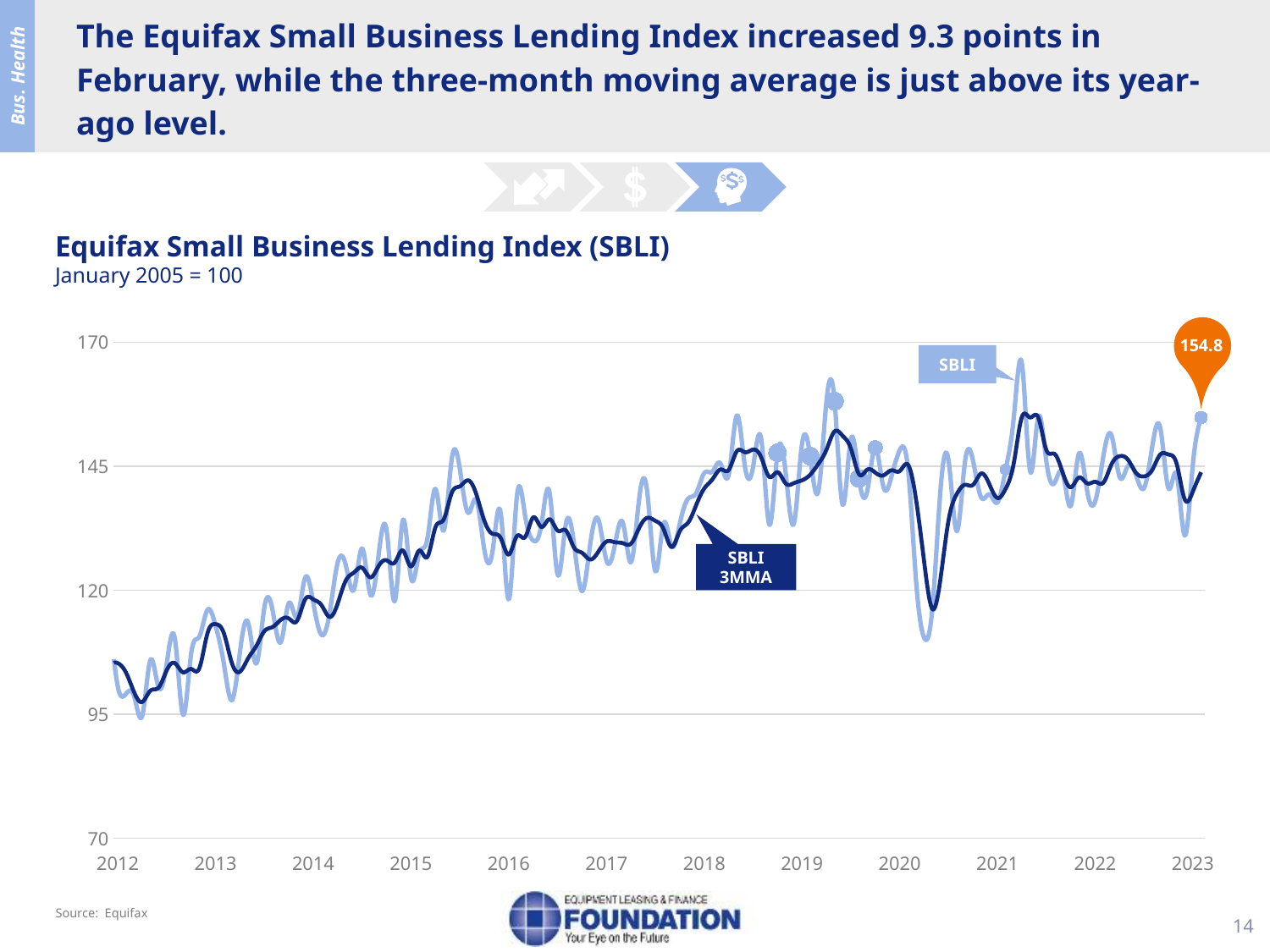
Is the SBLI value at the start of 2012 greater or less than 120? less Which is higher, the SBLI at the start of 2012 or the SBLI at the end of the series in 2023? 2023 Is the lowest SBLI value during 2020 greater or less than 120? less How many series are plotted on the chart? 2 What is the most recent SBLI value labeled on the chart? 154.8 Is the latest SBLI value greater or less than 145? greater What kind of chart is shown on the slide? line chart What base period is the index set to 100, according to the chart subtitle? January 2005 = 100 What are the names of the two series plotted on the chart? SBLI and SBLI 3MMA Overall, does the SBLI rise or fall from 2012 to 2023? rise How many year labels are shown on the x axis? 12